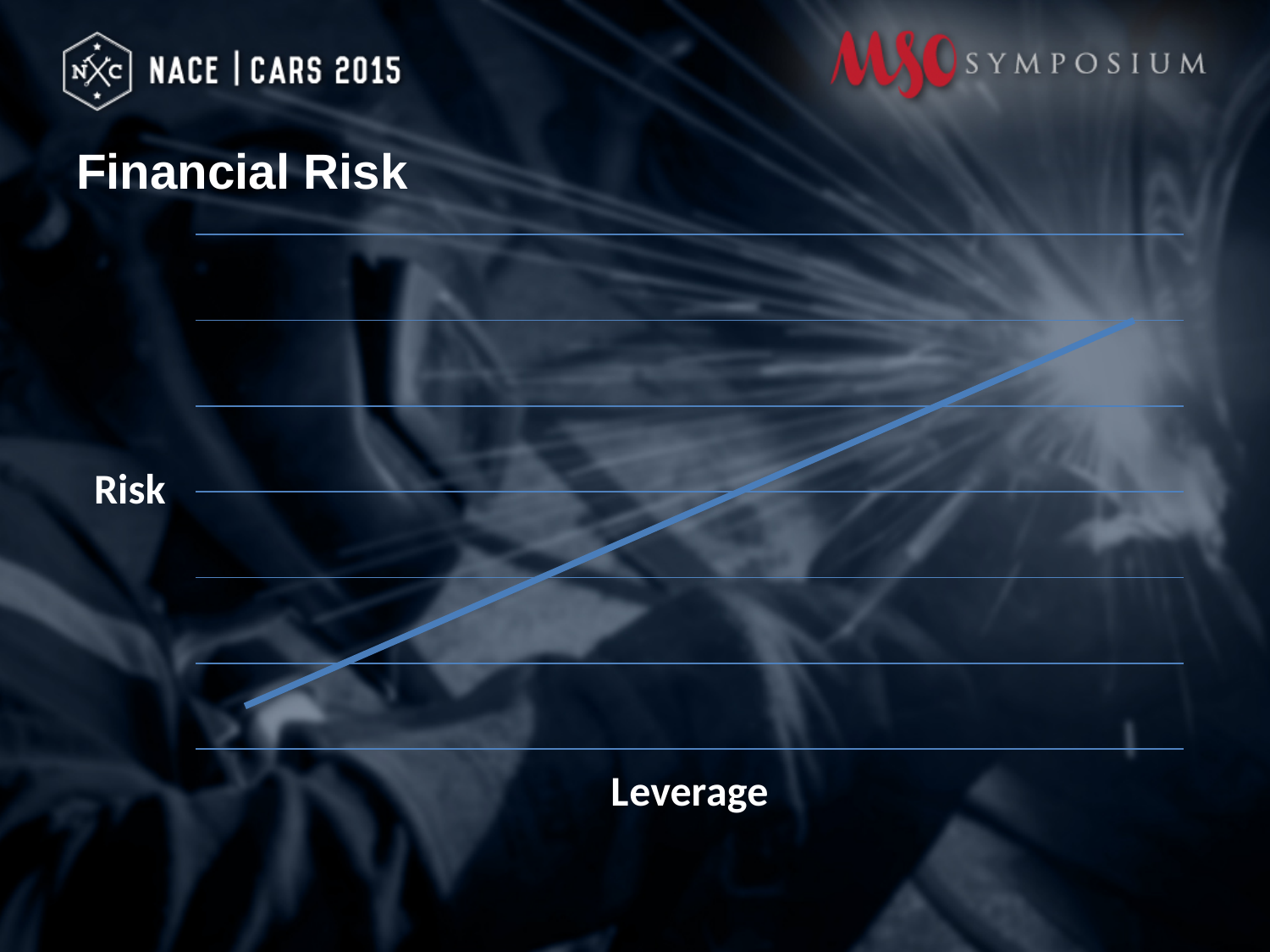
What kind of chart is shown on the slide? Line chart What is the label on the horizontal axis of the chart? Leverage What is the label on the vertical axis of the chart? Risk Does the plotted line rise or fall as leverage increases along the x axis? Rises